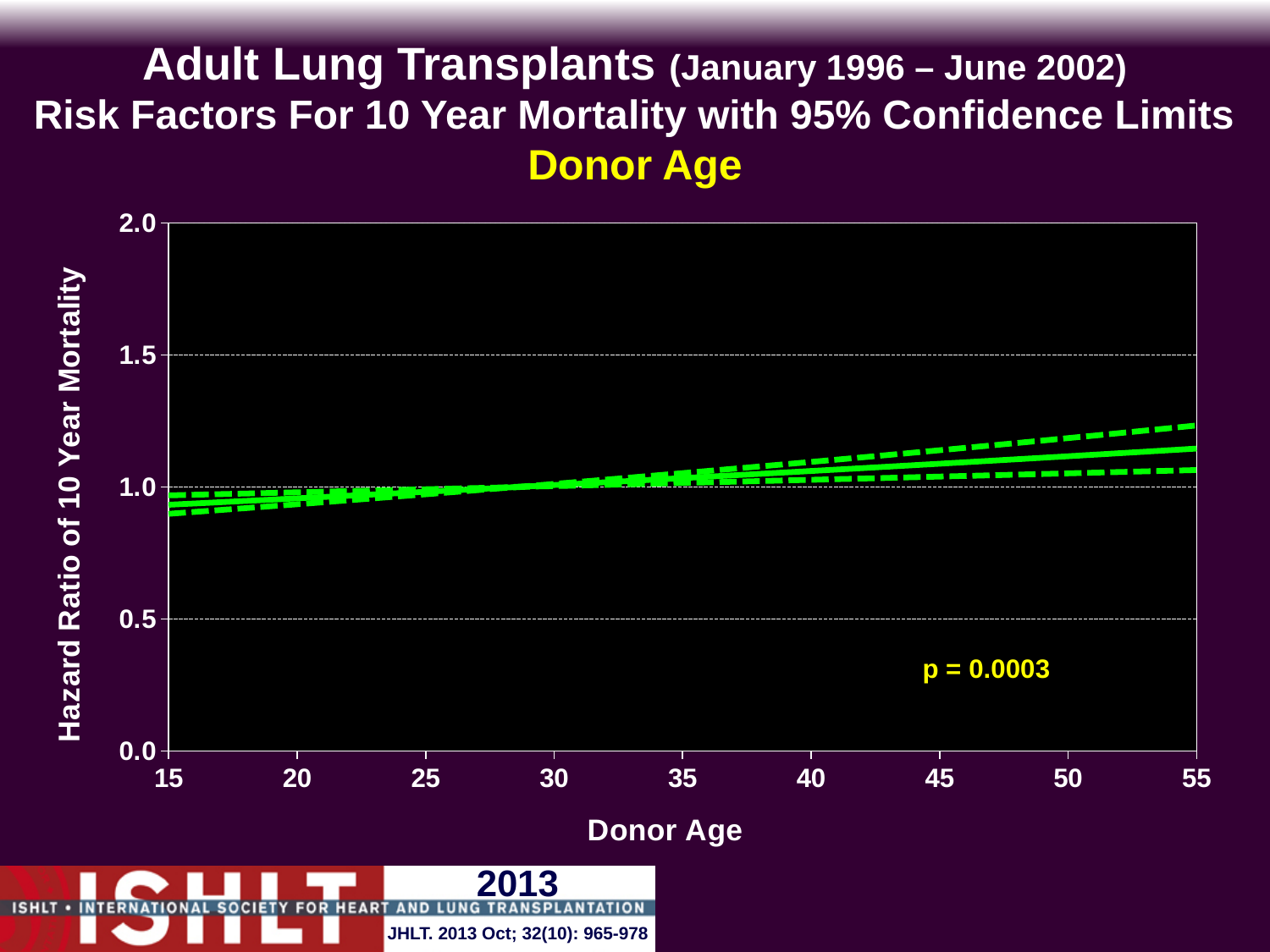
Is the hazard ratio at donor age 15 greater or less than 1.0? less What is the label of the y axis? Hazard Ratio of 10 Year Mortality How many tick labels are shown on the Donor Age axis? 9 Is the hazard ratio at donor age 55 greater or less than 1.5? less Does the hazard ratio of 10 year mortality rise or fall as donor age increases from 15 to 55? rises What is the p-value printed on the chart? p = 0.0003 What kind of chart is shown on the slide? line chart Is the hazard ratio at donor age 55 greater or less than 1.0? greater Which donor age has the larger hazard ratio, 15 or 55? 55